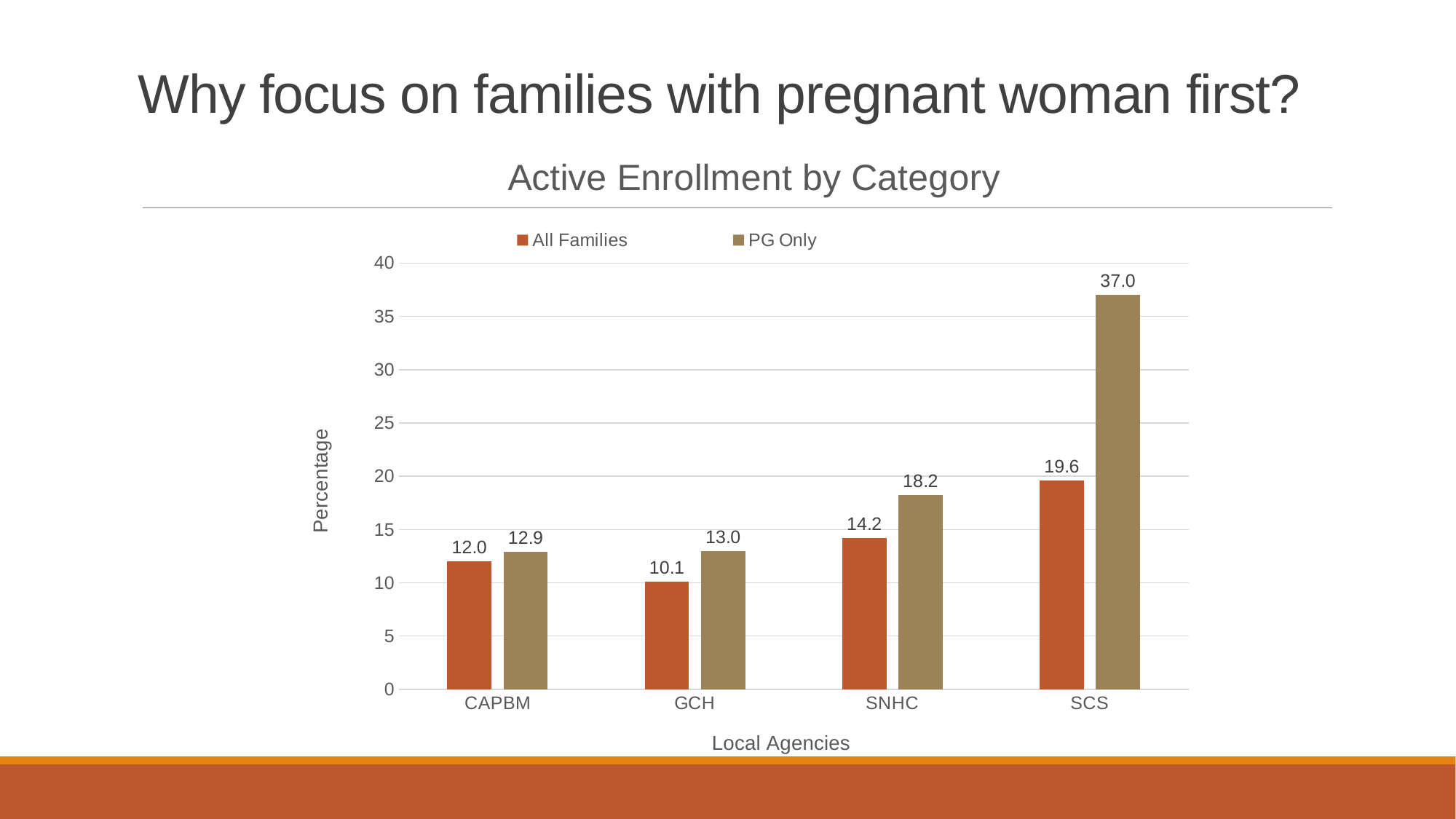
How many local agencies are shown on the x axis? 4 What kind of chart is shown on the slide? Bar chart What is the difference between the PG Only and All Families values for SCS? 17.4 Which is larger, the All Families value for SNHC or the All Families value for CAPBM? SNHC What is the difference between the PG Only and All Families values for SNHC? 4.0 What is the PG Only value for GCH? 13.0 What is the All Families value for SCS? 19.6 What is the All Families value for CAPBM? 12.0 What is the title of the chart? Active Enrollment by Category Which local agency has the highest PG Only value? SCS Which local agency has the lowest All Families value? GCH How many series does the legend list? 2